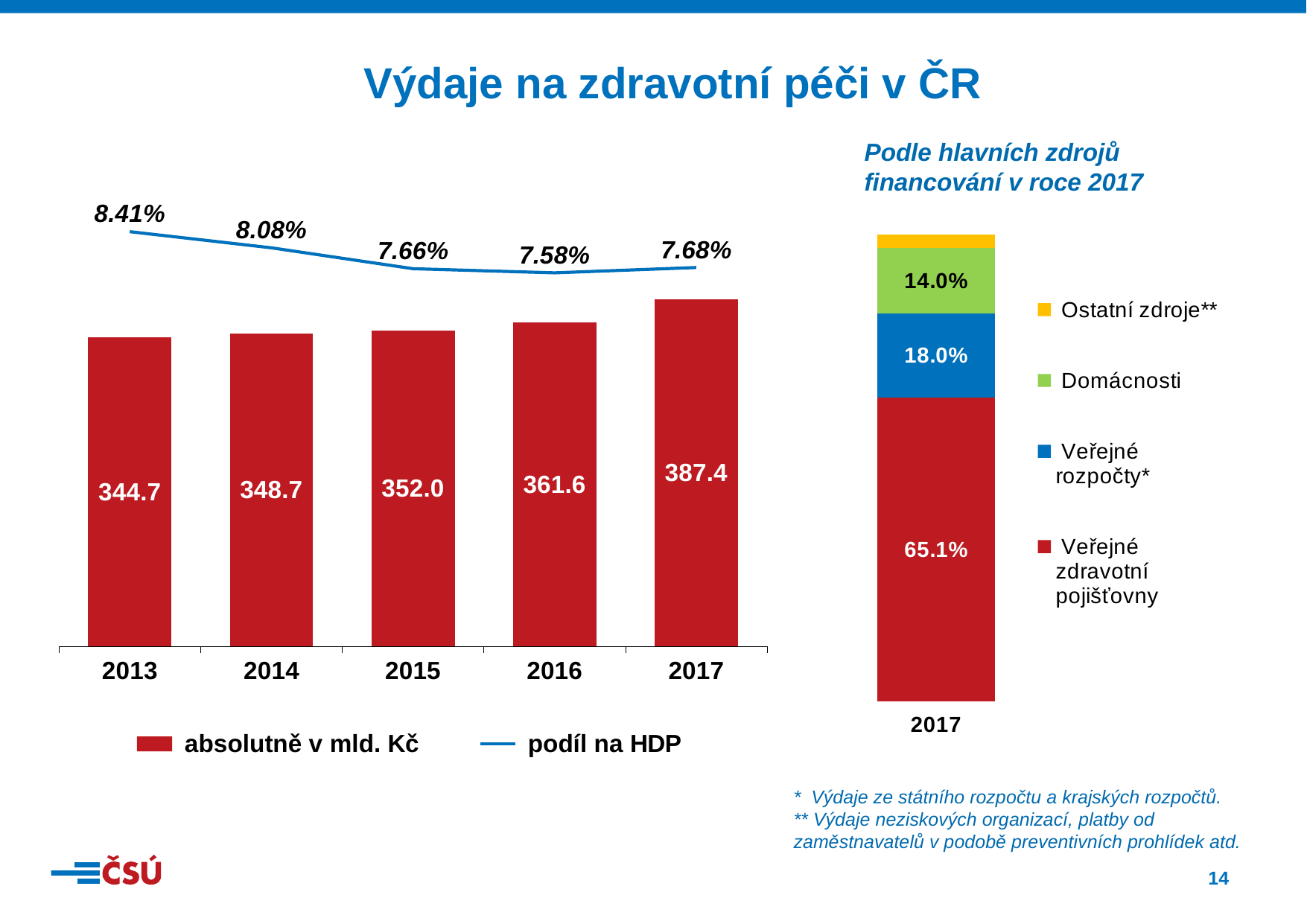
In the left chart, what is the 'podíl na HDP' value for 2013? 8.41% In the left chart, is the 'podíl na HDP' higher in 2014 or in 2015? 2014 In the right chart 'Podle hlavních zdrojů financování v roce 2017', which colour represents 'Veřejné rozpočty*'? blue In the left chart, what is the difference in 'absolutně v mld. Kč' between 2017 and 2016? 25.8 In the left chart, which year has the highest value of 'absolutně v mld. Kč'? 2017 In the left chart, do the 'absolutně v mld. Kč' values rise or fall from 2013 to 2017? rise In the left chart, how many series does the legend list? 2 In the right chart 'Podle hlavních zdrojů financování v roce 2017', what share is 'Veřejné zdravotní pojišťovny'? 65.1% In the right chart 'Podle hlavních zdrojů financování v roce 2017', what share is 'Domácnosti'? 14.0% In the left chart, what is the value of 'absolutně v mld. Kč' for 2017? 387.4 In the left chart, which year has the lowest 'podíl na HDP'? 2016 In the left chart, how many years are shown on the x axis? 5